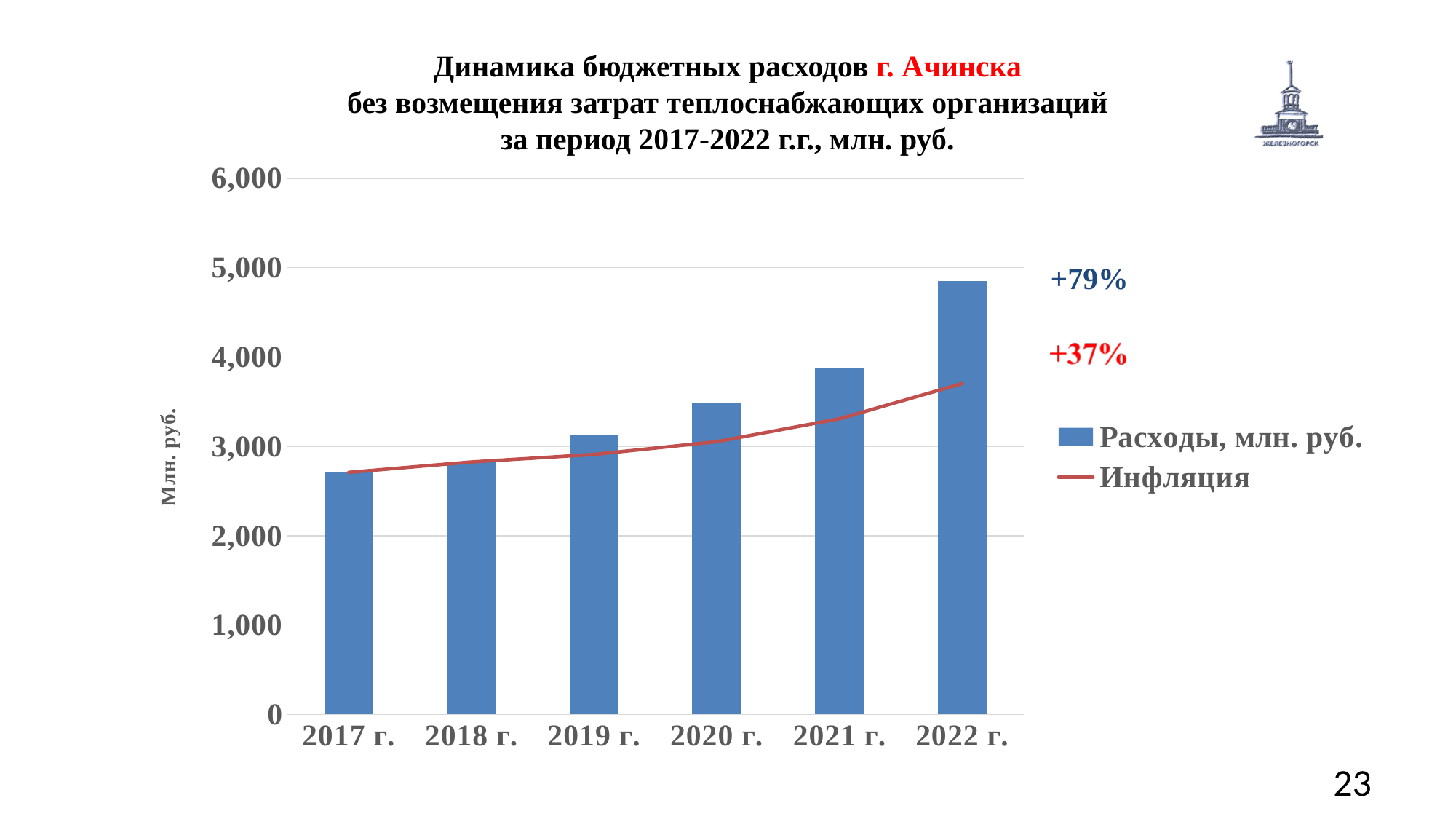
Which year has the highest value for Расходы, млн. руб.? 2022 г. How many series does the legend list? 2 Is the value for Расходы in 2021 г. greater or less than 4,000? less What kind of chart is shown on the slide? Bar chart with a line Which is larger, the Расходы value for 2020 г. or for 2018 г.? 2020 г. Which year has the lowest value for Расходы, млн. руб.? 2017 г. Do the Расходы values rise or fall from 2017 г. to 2022 г.? Rise Is the value for Расходы in 2017 г. greater or less than 3,000? less Is the value for Расходы in 2020 г. greater or less than 3,000? greater How many years are shown on the x axis? 6 What percentage growth is shown in blue next to the chart? +79%